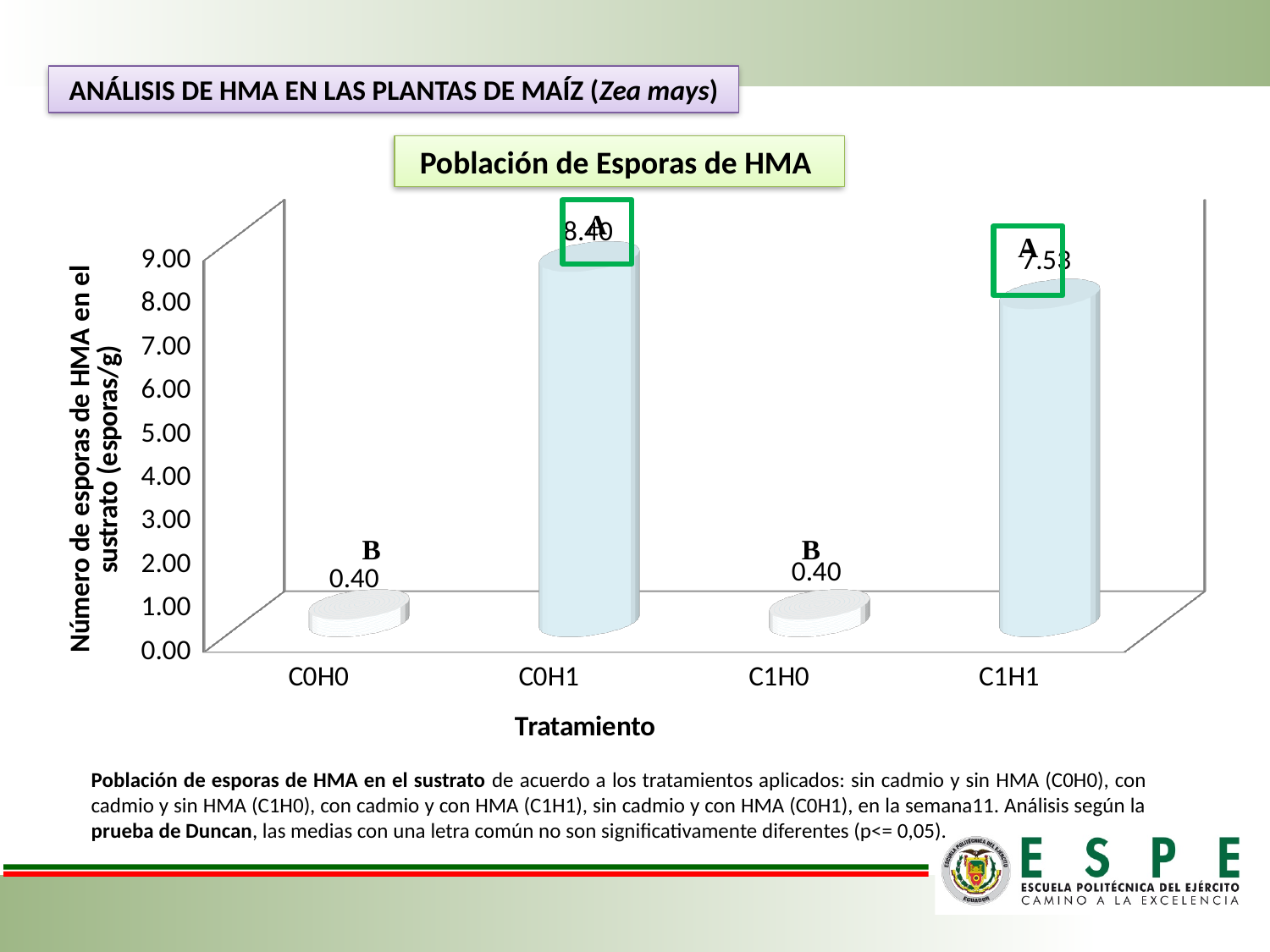
What is the difference between the values for C0H1 and C1H1? 0.87 What is the value for C0H0? 0.40 How many treatments are shown on the x axis? 4 Which treatment has the highest number of spores? C0H1 What is the value for C1H1? 7.53 Which is larger, the value for C0H1 or the value for C1H1? C0H1 What is the value for C0H1? 8.40 Is the value for C1H1 greater or less than 5.00? greater What kind of chart is shown? bar chart What is the x-axis title of the chart? Tratamiento What is the title of the chart? Población de Esporas de HMA What is the value for C1H0? 0.40